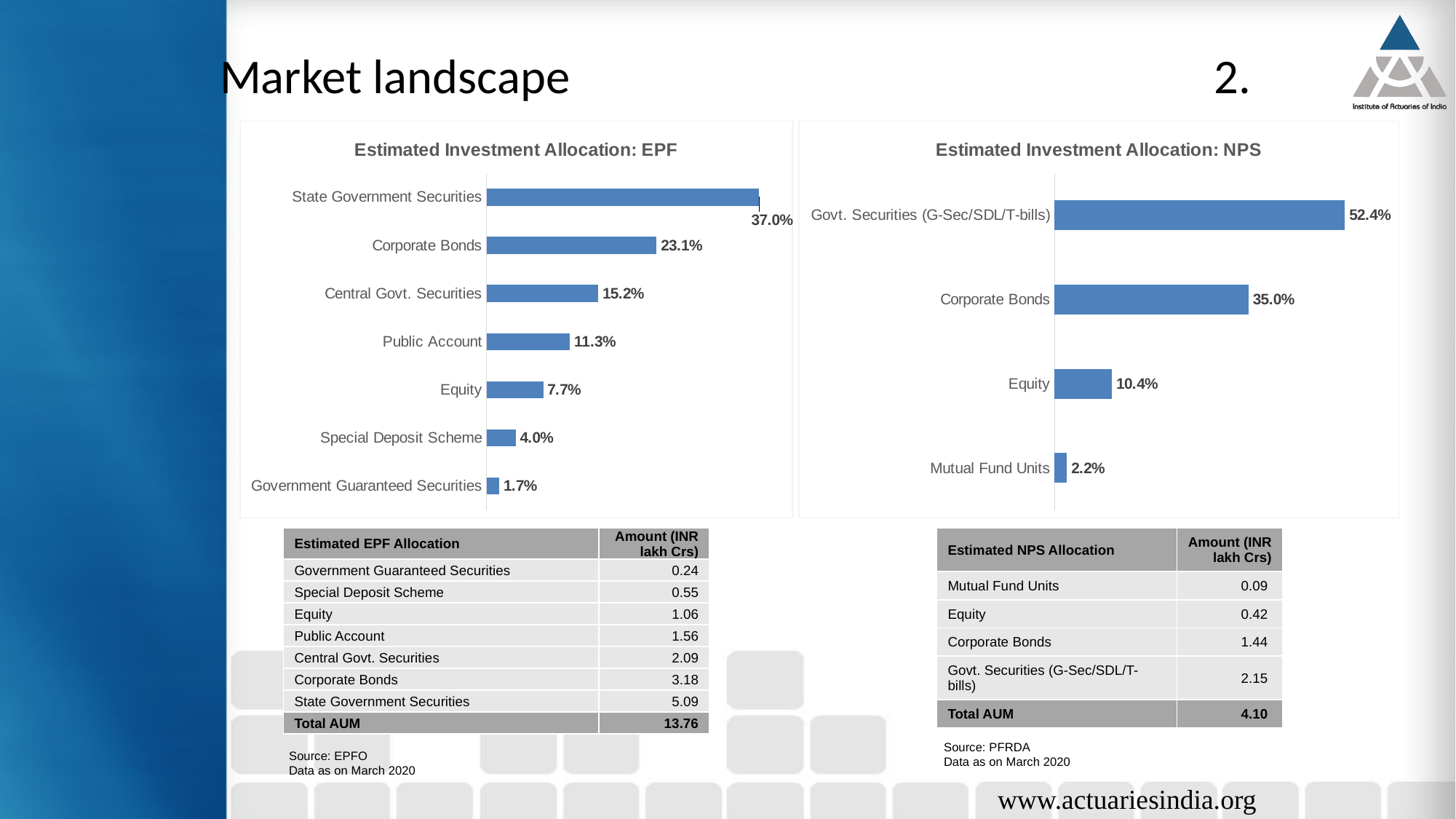
In the 'Estimated Investment Allocation: NPS' chart, what is the value for Mutual Fund Units? 2.2% In the 'Estimated Investment Allocation: NPS' chart, what is the value for Govt. Securities (G-Sec/SDL/T-bills)? 52.4% In the 'Estimated Investment Allocation: NPS' chart, what is the difference between Corporate Bonds and Equity? 24.6% In the 'Estimated Investment Allocation: EPF' chart, what is the difference between Central Govt. Securities and Equity? 7.5% In the 'Estimated Investment Allocation: EPF' chart, what is the value for Public Account? 11.3% In the 'Estimated Investment Allocation: NPS' chart, how many categories are shown? 4 In the 'Estimated Investment Allocation: EPF' chart, what is the value for Corporate Bonds? 23.1% In the 'Estimated Investment Allocation: EPF' chart, which category has the highest value? State Government Securities What type of chart is the 'Estimated Investment Allocation: NPS' chart? Bar chart In the 'Estimated Investment Allocation: NPS' chart, which category has the lowest value? Mutual Fund Units In the 'Estimated Investment Allocation: EPF' chart, how many categories are shown? 7 In the 'Estimated Investment Allocation: EPF' chart, which category has the lowest value? Government Guaranteed Securities